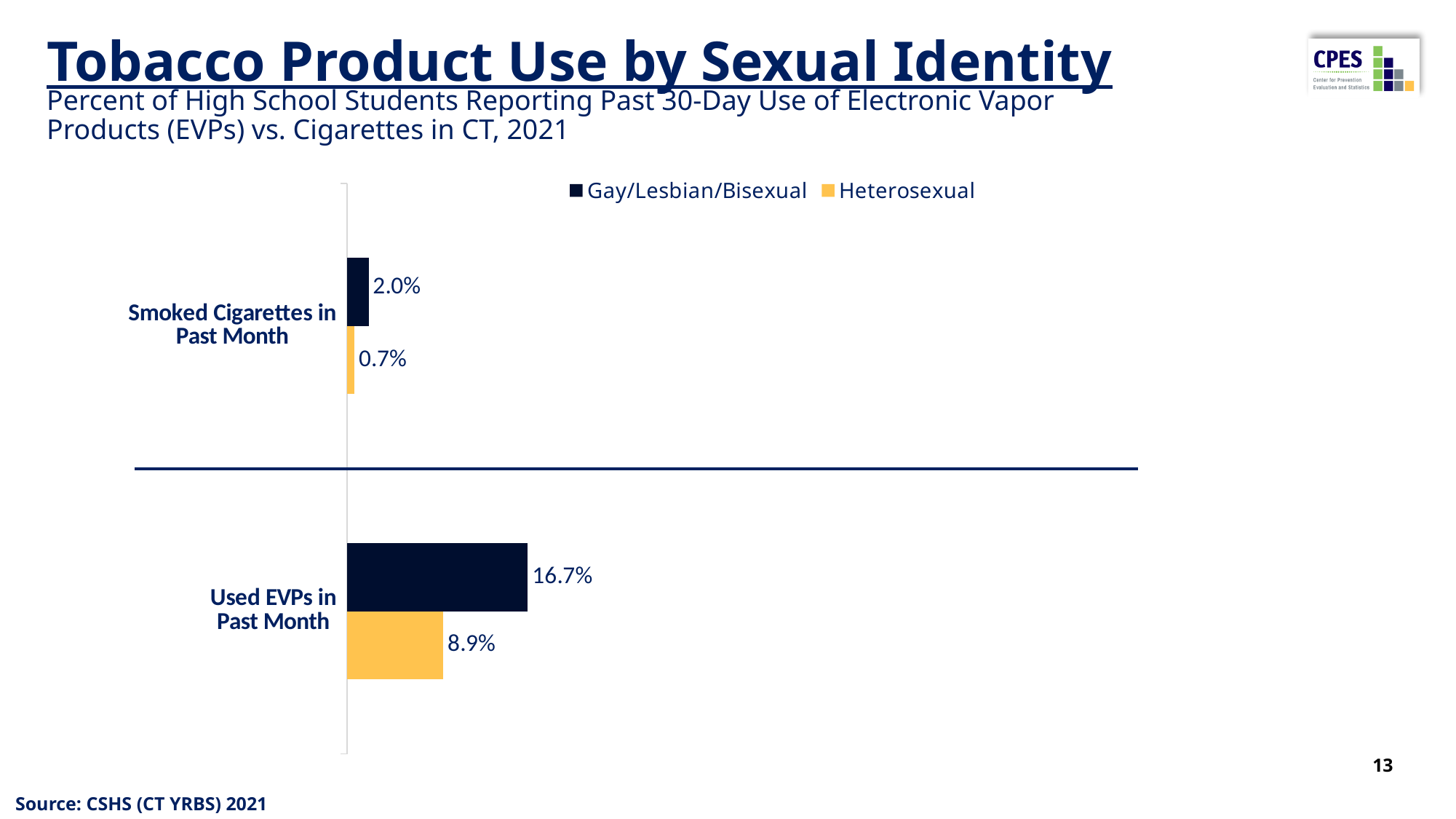
Which group and behavior has the lowest value on the chart? Heterosexual, Smoked Cigarettes in Past Month What is the difference between Gay/Lesbian/Bisexual and Heterosexual students in past-month cigarette smoking? 1.3% What kind of chart is shown on the slide? Bar chart How many series does the legend list? 2 Which group and behavior has the highest value on the chart? Gay/Lesbian/Bisexual, Used EVPs in Past Month Which group has a higher rate of past-month cigarette smoking, Gay/Lesbian/Bisexual or Heterosexual? Gay/Lesbian/Bisexual What is the difference between Gay/Lesbian/Bisexual and Heterosexual students in past-month EVP use? 7.8% What percent of Gay/Lesbian/Bisexual high school students reported using EVPs in the past month? 16.7% What percent of Heterosexual high school students reported using EVPs in the past month? 8.9% What percent of Gay/Lesbian/Bisexual students reported smoking cigarettes in the past month? 2.0% Which colour represents the Heterosexual series in the chart? Yellow What percent of Heterosexual students reported smoking cigarettes in the past month? 0.7%